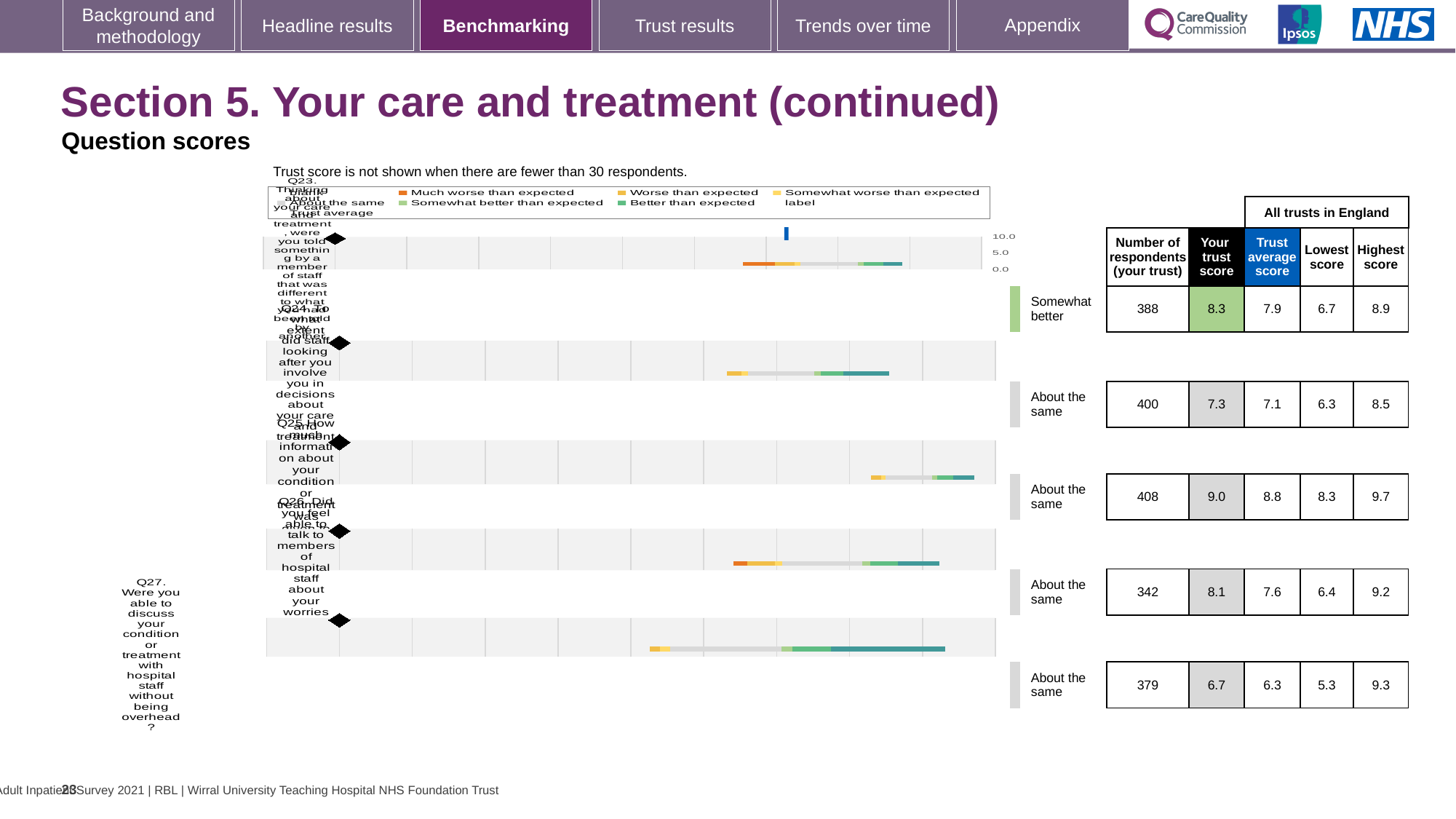
What is the trust score for Q23 shown in the 'Your trust score' column? 8.3 What is the difference between the trust score (8.3) and the trust average score (7.9) for Q23? 0.4 What is the highest score across all trusts in England for Q26? 9.2 What kind of chart is used to show the question scores on this slide? bar chart Which question is rated 'Somewhat better' rather than 'About the same'? Q23 Which question has the highest 'Your trust score'? Q25 What is the maximum value shown on the chart's score axis? 10.0 How many questions (Q23 to Q27) are plotted on the chart? 5 For Q24, which is larger: the trust score or the trust average score? the trust score Which question has the lowest 'Your trust score'? Q27 What is the trust average score for Q27? 6.3 How many respondents answered Q25 for this trust? 408